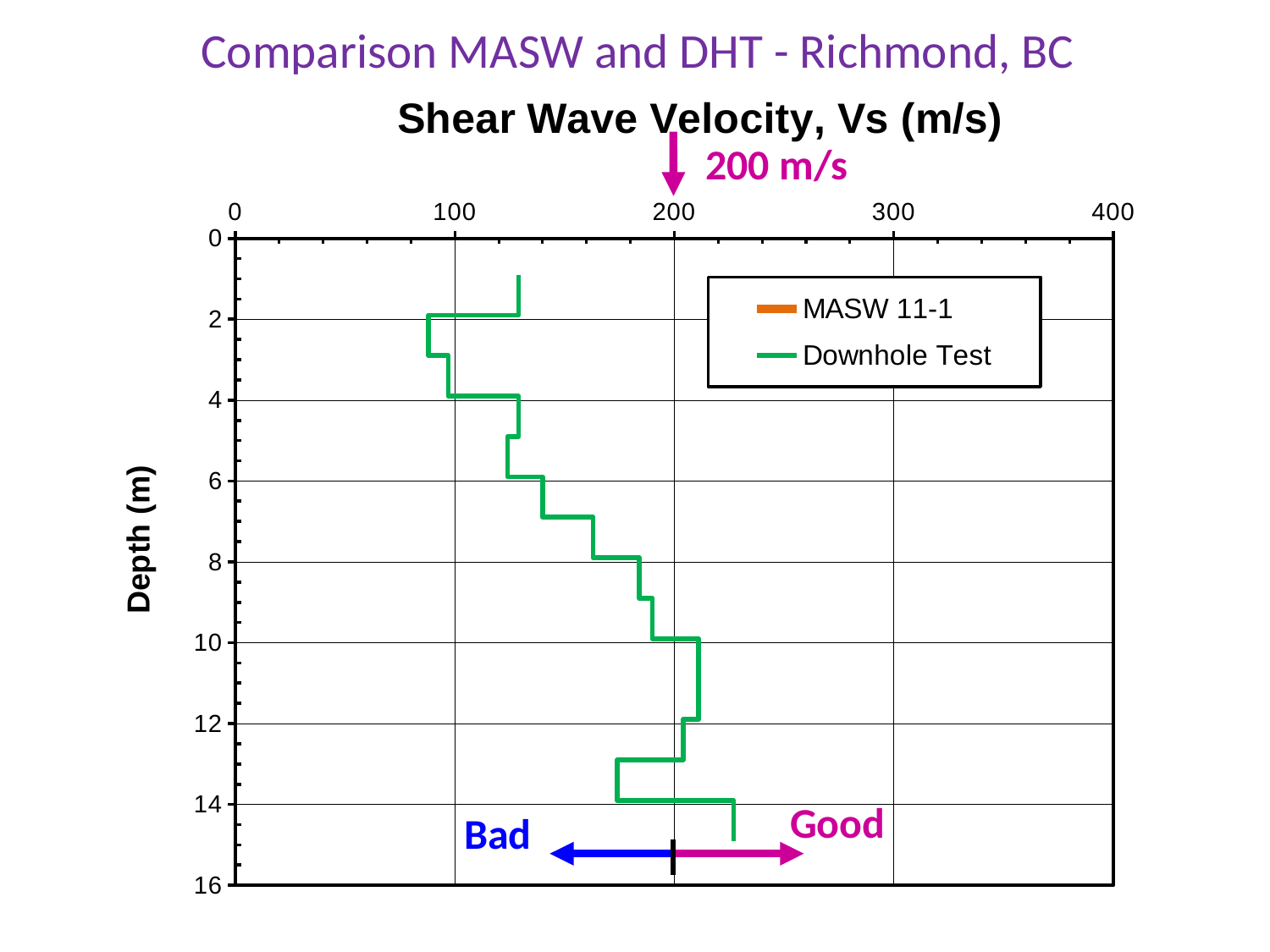
Does the Downhole Test shear wave velocity generally increase or decrease as depth increases from 2 m to 12 m? increase Which is larger, the Downhole Test velocity at a depth of 3 m or at a depth of 11 m? 11 m What is the title of the horizontal axis? Shear Wave Velocity, Vs (m/s) Is the Downhole Test velocity at a depth of 7.5 m greater or less than 100? greater Is the Downhole Test velocity at a depth of 7.5 m greater or less than 300? less What is the title of the vertical axis? Depth (m) Is the Downhole Test velocity at a depth of 11 m greater or less than 200? greater What kind of chart is shown on the slide? line chart How many series does the legend list? 2